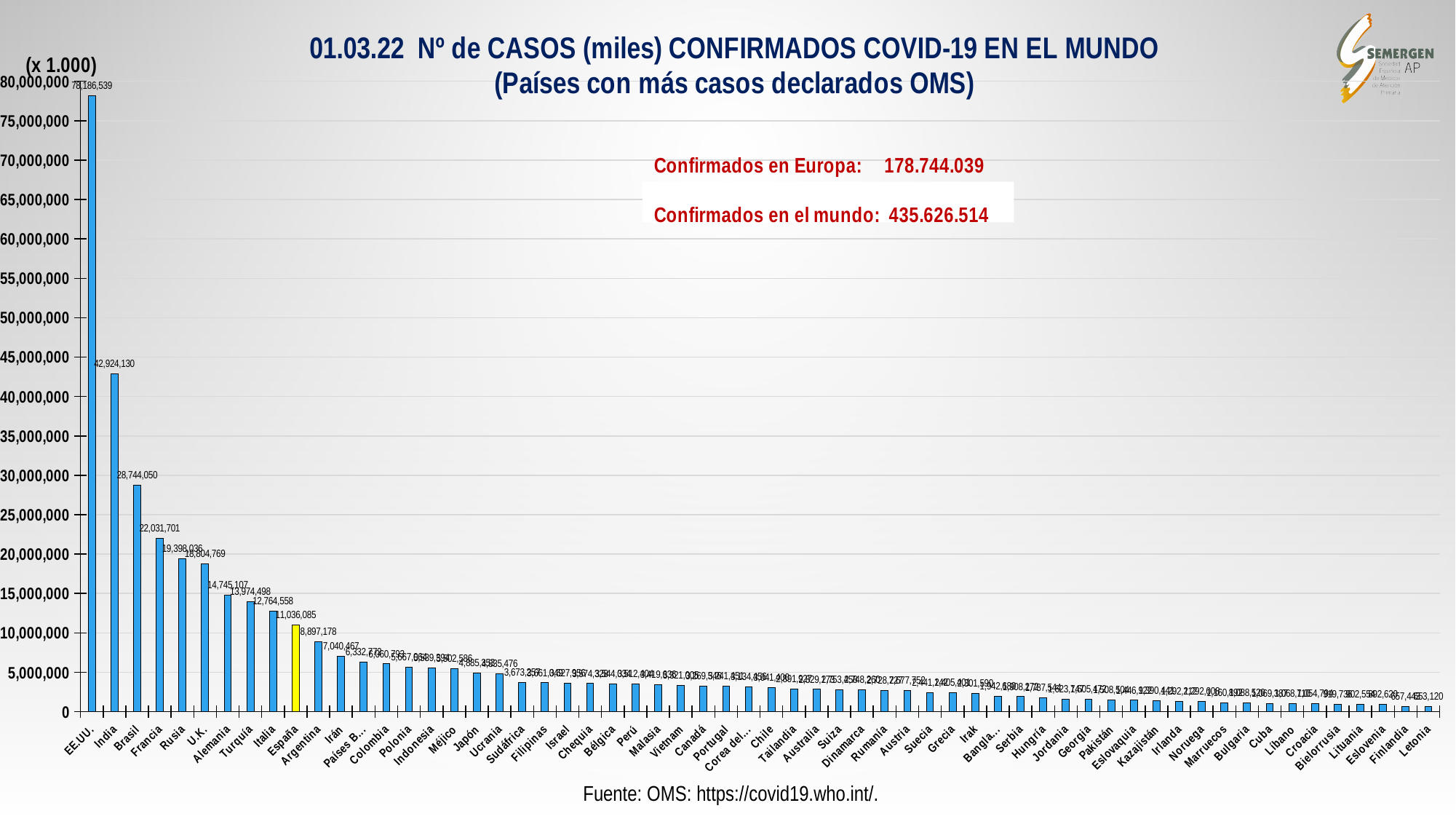
Which is larger, the value for Rusia or the value for U.K.? Rusia Which country has the highest number of confirmed cases? EE.UU. Which country has the lowest number of confirmed cases on the chart? Letonia What is the value for España? 11,036,085 What is the value for Argentina? 8,897,178 Which country's bar is highlighted in yellow? España What is the value for India? 42,924,130 What is the value for EE.UU.? 78,186,539 What is the difference between the values for EE.UU. and India? 35,262,409 What kind of chart is shown on the slide? Bar chart What is the difference between the values for Italia and España? 1,728,473 Is the value for Colombia greater or less than 10,000,000? less